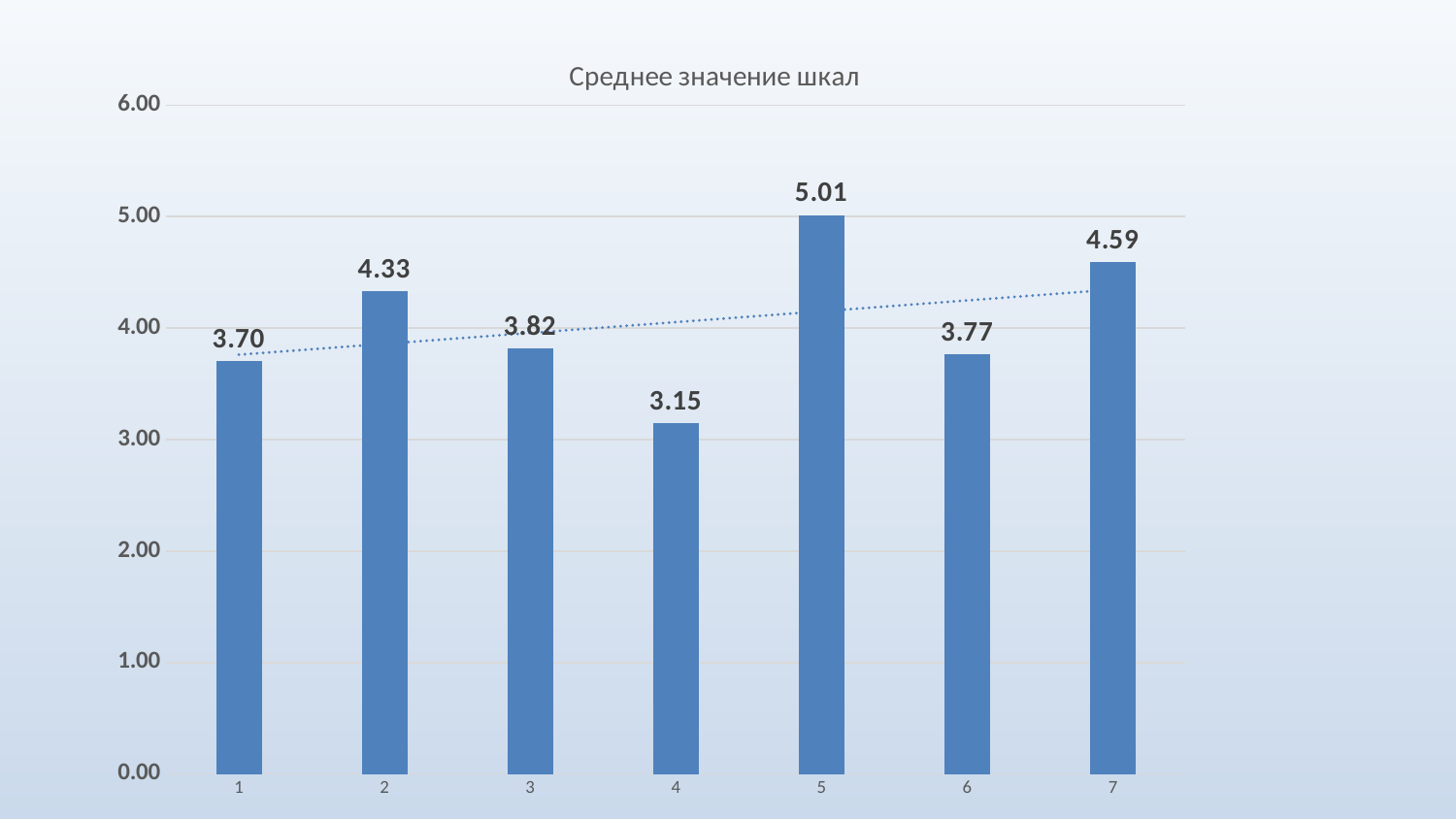
Which category has the lowest value? 4 What is the value for category 7? 4.59 What is the value for category 1? 3.70 How many categories are shown on the x axis? 7 Is the value for category 6 greater or less than 4.00? less What is the value for category 4? 3.15 What is the difference between the values for category 5 and category 4? 1.86 Which category has the highest value? 5 Which is larger, the value for category 2 or the value for category 3? Category 2 What kind of chart is shown on the slide? Bar chart What is the title of the chart? Среднее значение шкал What is the value for category 5? 5.01